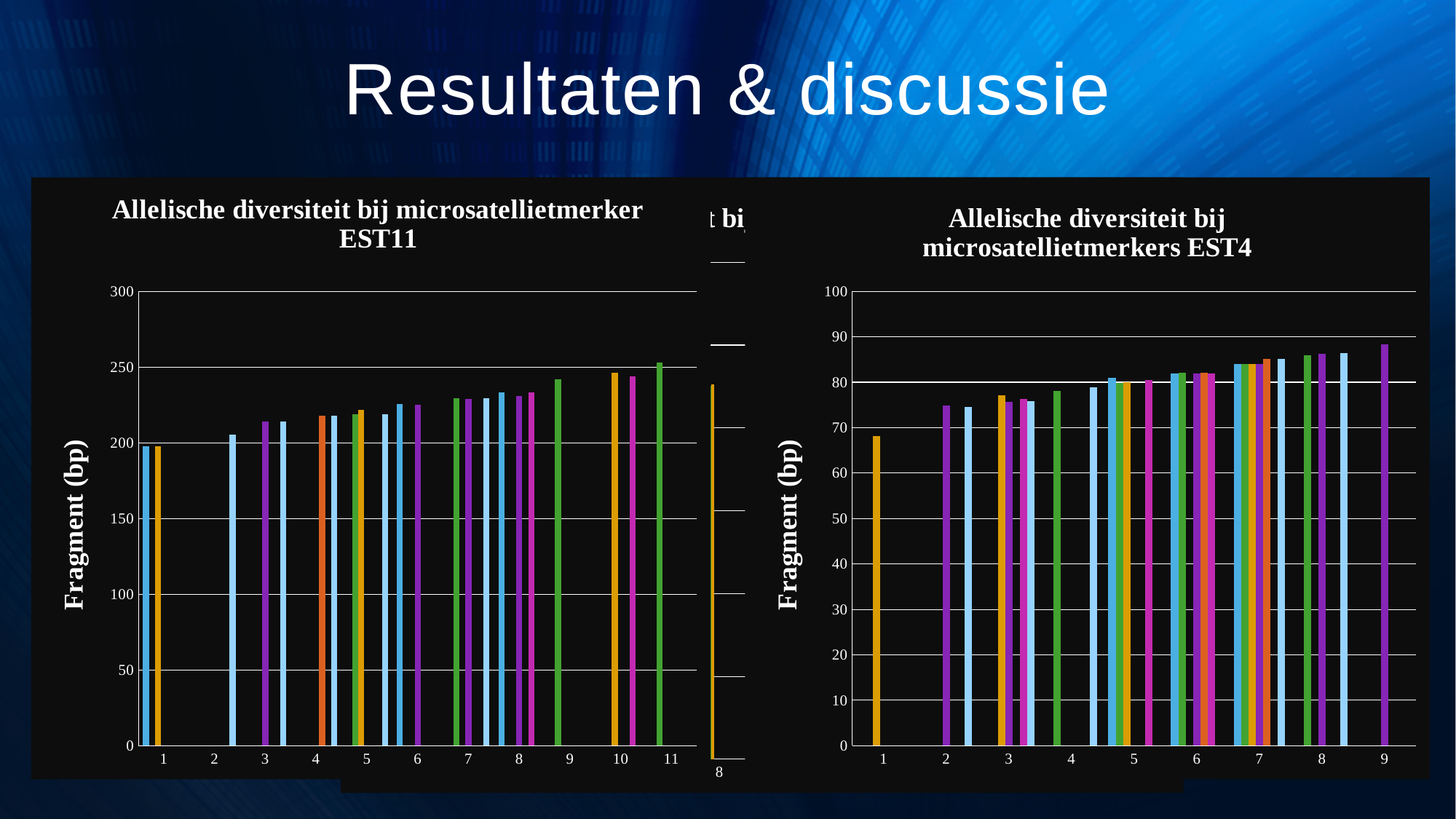
In the chart titled 'Allelische diversiteit bij microsatellietmerker EST11', is the bar for category 9 greater or less than 250? less In the chart titled 'Allelische diversiteit bij microsatellietmerker EST11', is the bar for category 2 greater or less than 200? greater What is the y-axis label of the chart titled 'Allelische diversiteit bij microsatellietmerkers EST4'? Fragment (bp) In the chart titled 'Allelische diversiteit bij microsatellietmerkers EST4', is the bar for category 4 greater or less than 80? less In the chart titled 'Allelische diversiteit bij microsatellietmerkers EST4', do the bar heights generally rise or fall from category 1 to category 9? rise In the chart titled 'Allelische diversiteit bij microsatellietmerker EST11', do the bar heights generally rise or fall from category 1 to category 11? rise How many categories are shown on the x axis of the chart titled 'Allelische diversiteit bij microsatellietmerker EST11'? 11 How many categories are shown on the x axis of the chart titled 'Allelische diversiteit bij microsatellietmerkers EST4'? 9 What kind of chart is the chart titled 'Allelische diversiteit bij microsatellietmerker EST11'? bar chart